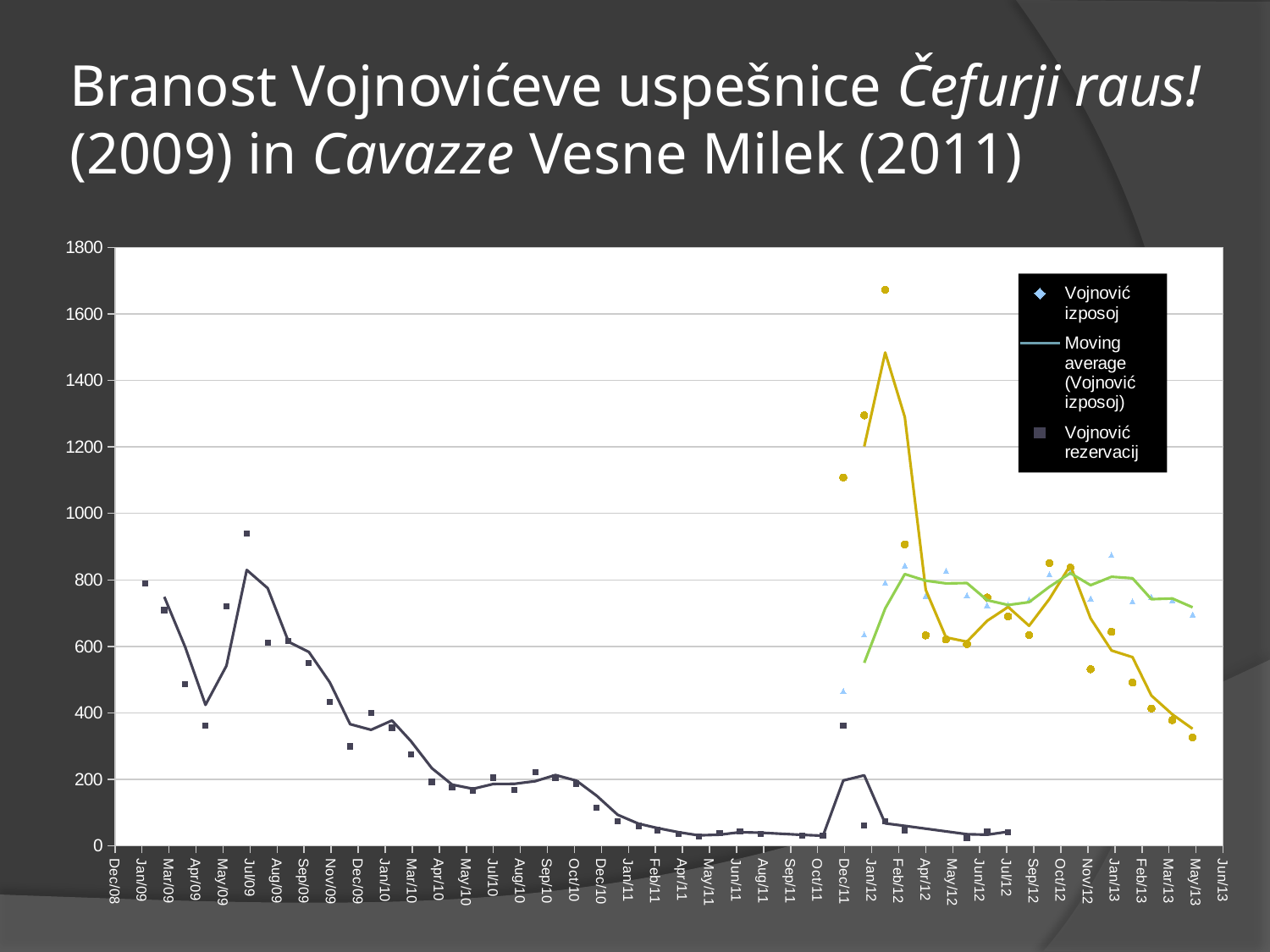
Is the highest gold-coloured data point, at Feb/12, greater or less than 1600? greater Which is larger for Vojnović rezervacij: the value for Jul/09 or the value for Apr/09? Jul/09 Do the Vojnović rezervacij values rise or fall between Jul/09 and Jan/11? fall What kind of chart is shown on the slide? line chart What is the highest value shown on the vertical axis? 1800 What is the first month label on the horizontal axis? Dec/08 Do the gold-coloured data points rise or fall between Feb/12 and May/13? fall Is the Vojnović rezervacij value for Jul/09 greater or less than 800? greater Is the gold-coloured data point for May/13 greater or less than 400? less In which month does the Vojnović rezervacij series reach its highest value? Jul/09